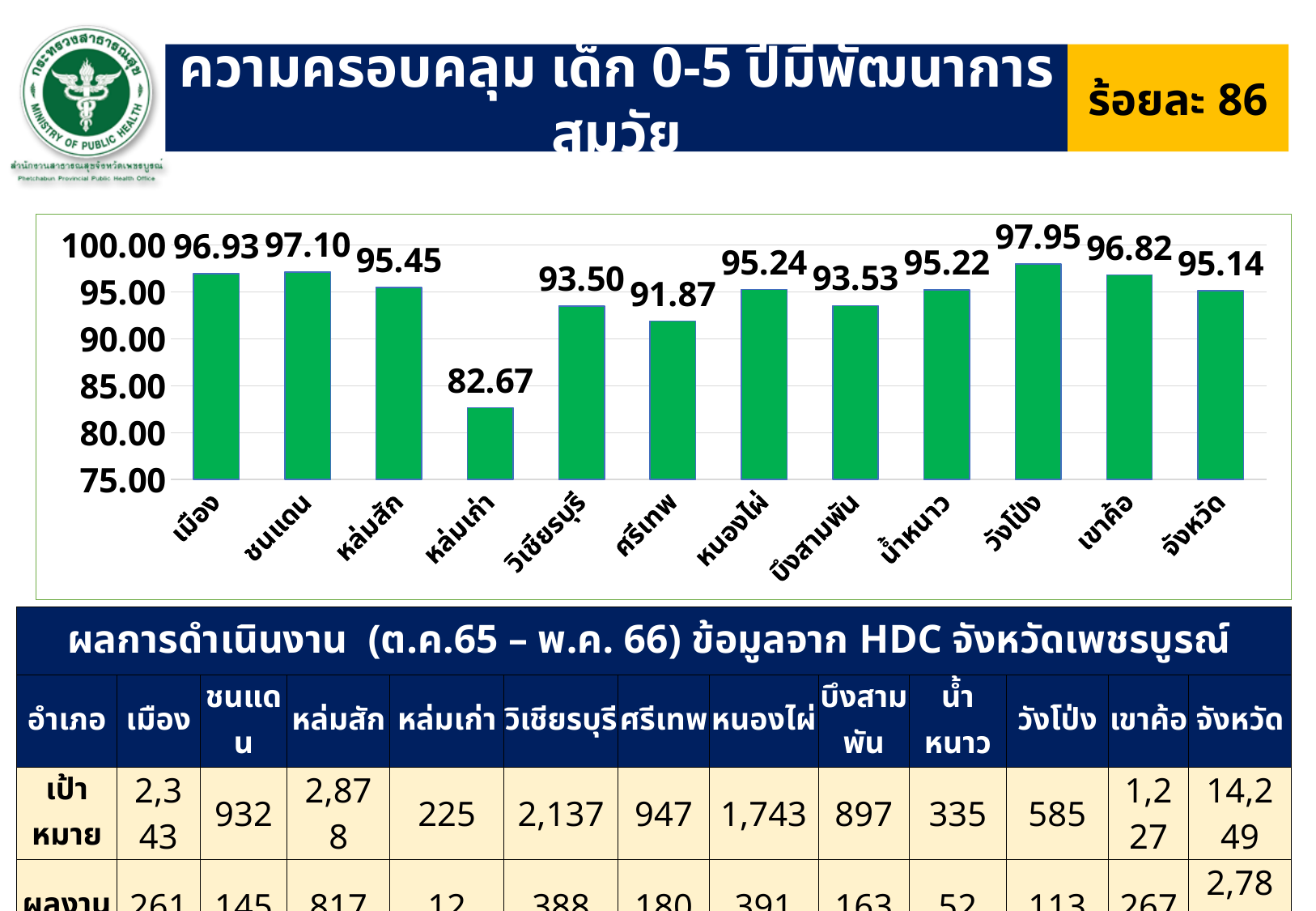
Is the value for หล่มเก่า greater or less than 85.00? less What colour are the bars in the chart? green Which category has the highest value in the bar chart? วังโป่ง How many categories are shown on the x axis of the bar chart? 12 What is the value for วังโป่ง in the bar chart? 97.95 What is the value for หล่มเก่า in the bar chart? 82.67 What is the difference between the values for วังโป่ง and หล่มเก่า? 15.28 Which category has the lowest value in the bar chart? หล่มเก่า What is the value for ศรีเทพ in the bar chart? 91.87 What kind of chart is shown on the slide? bar chart Which is larger, the value for ชนแดน or the value for เมือง? ชนแดน What is the value for จังหวัด in the bar chart? 95.14